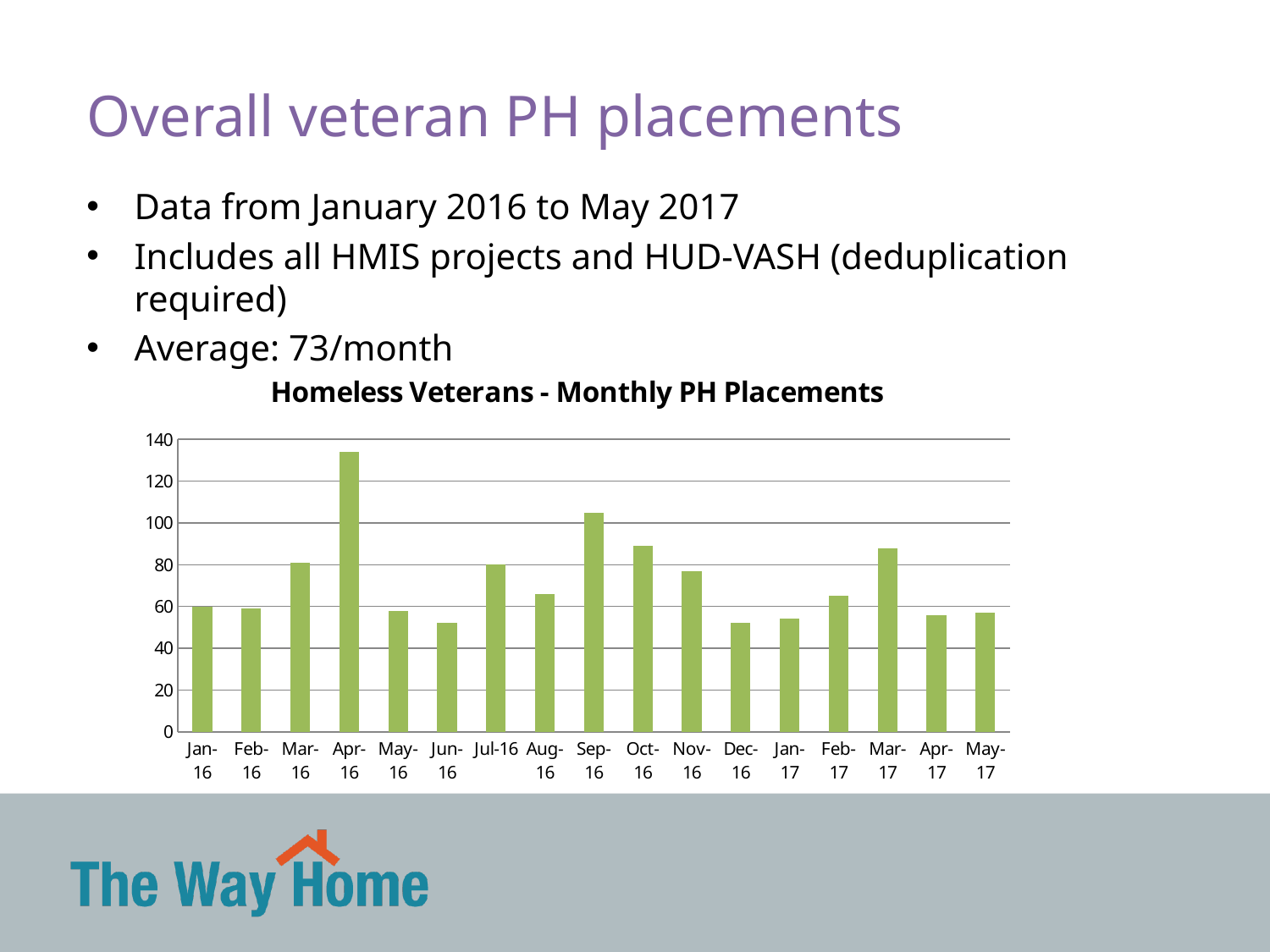
What is the title of the chart? Homeless Veterans - Monthly PH Placements Which month has the highest number of PH placements? Apr-16 Is the value for Oct-16 greater or less than 80? greater Is the value for Sep-16 greater or less than 100? greater Do the values rise or fall from Sep-16 to Dec-16? fall Which is larger, the value for Mar-17 or the value for Apr-17? Mar-17 Which is larger, the value for Sep-16 or the value for Oct-16? Sep-16 How many months are plotted on the chart? 17 Is the value for Apr-16 greater or less than 120? greater What kind of chart is shown on the slide? bar chart